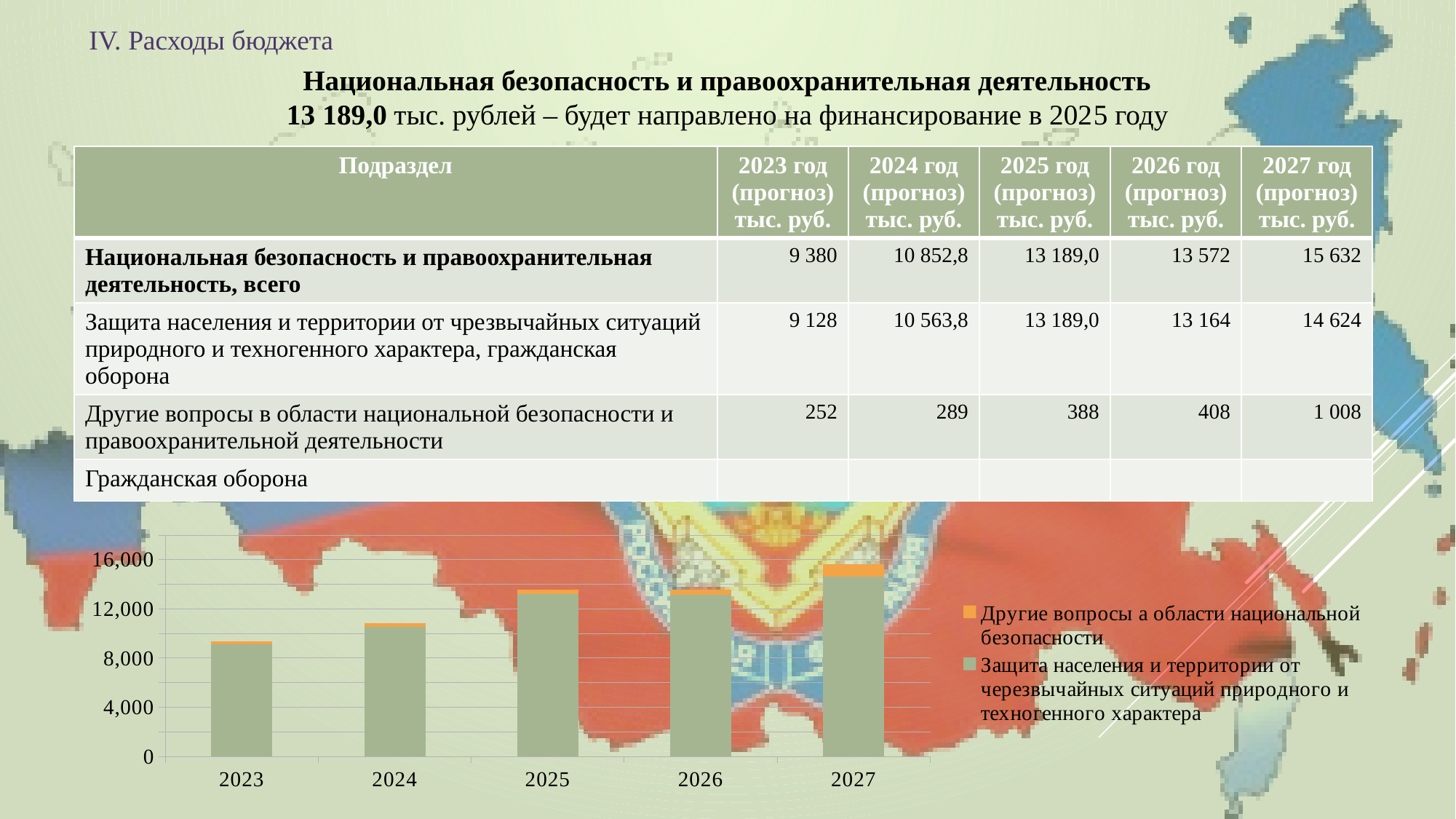
What kind of chart is shown at the bottom of the slide? bar chart Do the bars in the chart generally rise or fall from 2023 to 2027? rise Is the total bar for 2023 greater or less than 8,000? greater What colour represents the series 'Другие вопросы а области национальной безопасности' in the chart? orange Is the total bar for 2025 greater or less than 12,000? greater Which bar is taller in the chart, 2024 or 2025? 2025 Which year has the tallest bar in the chart? 2027 How many series does the chart legend list? 2 Which year has the shortest bar in the chart? 2023 Is the total bar for 2024 greater or less than 12,000? less How many years (bars) are shown on the x axis of the chart? 5